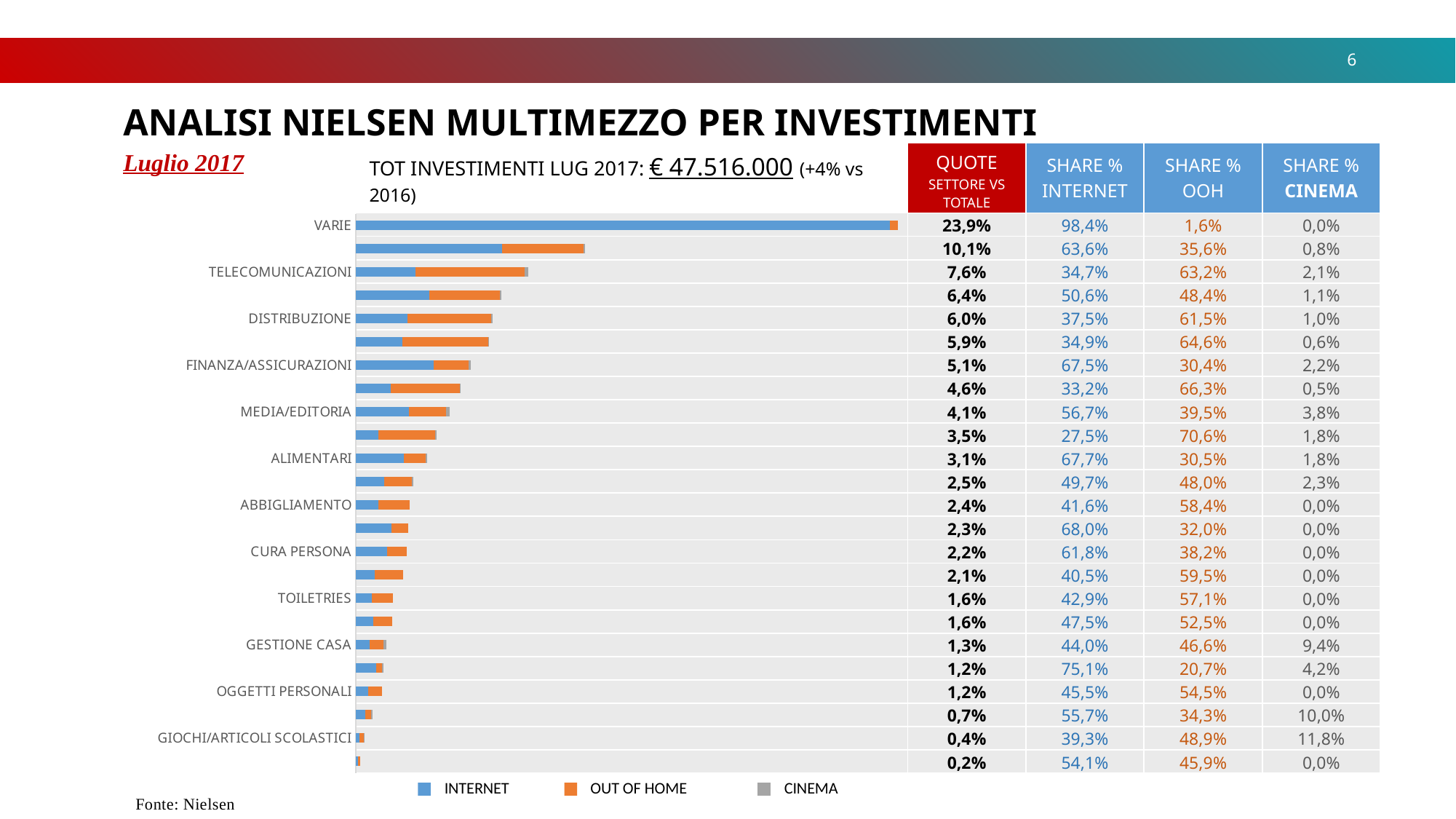
What is the QUOTE SETTORE VS TOTALE value for TELECOMUNICAZIONI? 7,6% What kind of chart is shown on the slide? Stacked horizontal bar chart What is the SHARE % INTERNET value for VARIE? 98,4% Which colour represents OUT OF HOME in the chart legend? Orange Which category has the longest bar in the chart? VARIE Which has the larger QUOTE SETTORE VS TOTALE, TELECOMUNICAZIONI or DISTRIBUZIONE? TELECOMUNICAZIONI What is the difference between the QUOTE SETTORE VS TOTALE of VARIE and that of TELECOMUNICAZIONI? 16,3% Do the bar lengths increase or decrease going from the top of the chart to the bottom? Decrease What total investment figure for July 2017 is shown above the chart? € 47.516.000 How many series does the chart legend list? 3 What is the SHARE % OOH value for DISTRIBUZIONE? 61,5% What is the SHARE % CINEMA value for GIOCHI/ARTICOLI SCOLASTICI? 11,8%